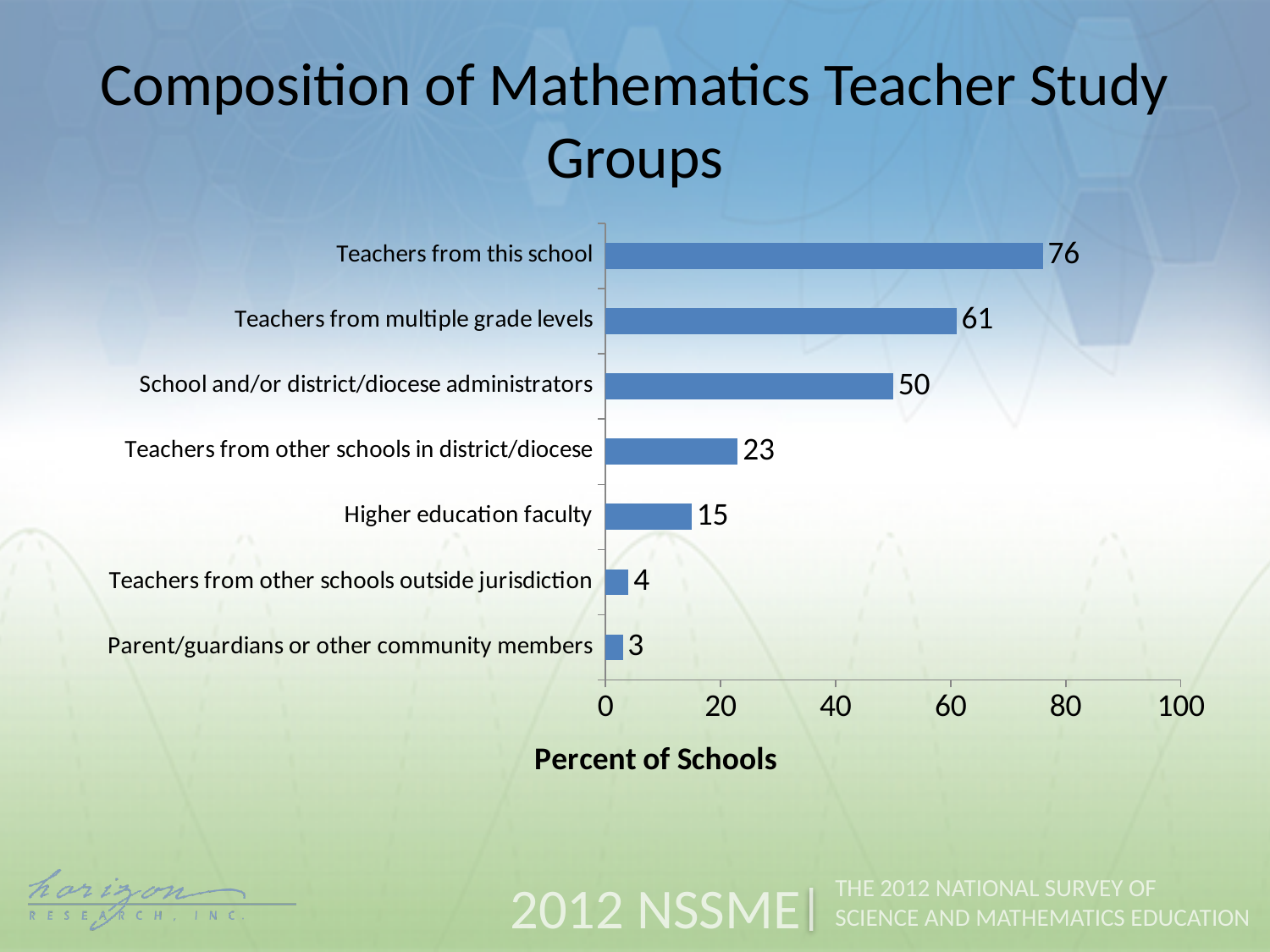
What is the difference between the values for Teachers from other schools in district/diocese and Higher education faculty? 8 What is the value for School and/or district/diocese administrators? 50 What percent of schools have teachers from this school in their mathematics teacher study groups? 76 What is the difference between the values for Teachers from this school and Teachers from multiple grade levels? 15 What is the label of the horizontal axis? Percent of Schools Which is larger: the value for Teachers from other schools outside jurisdiction or Parent/guardians or other community members? Teachers from other schools outside jurisdiction Which category has the highest percent of schools? Teachers from this school What kind of chart is shown on the slide? bar chart What is the value for Higher education faculty? 15 Which category has the lowest percent of schools? Parent/guardians or other community members Is the value for Teachers from multiple grade levels greater or less than 60? greater How many categories are shown in the chart? 7